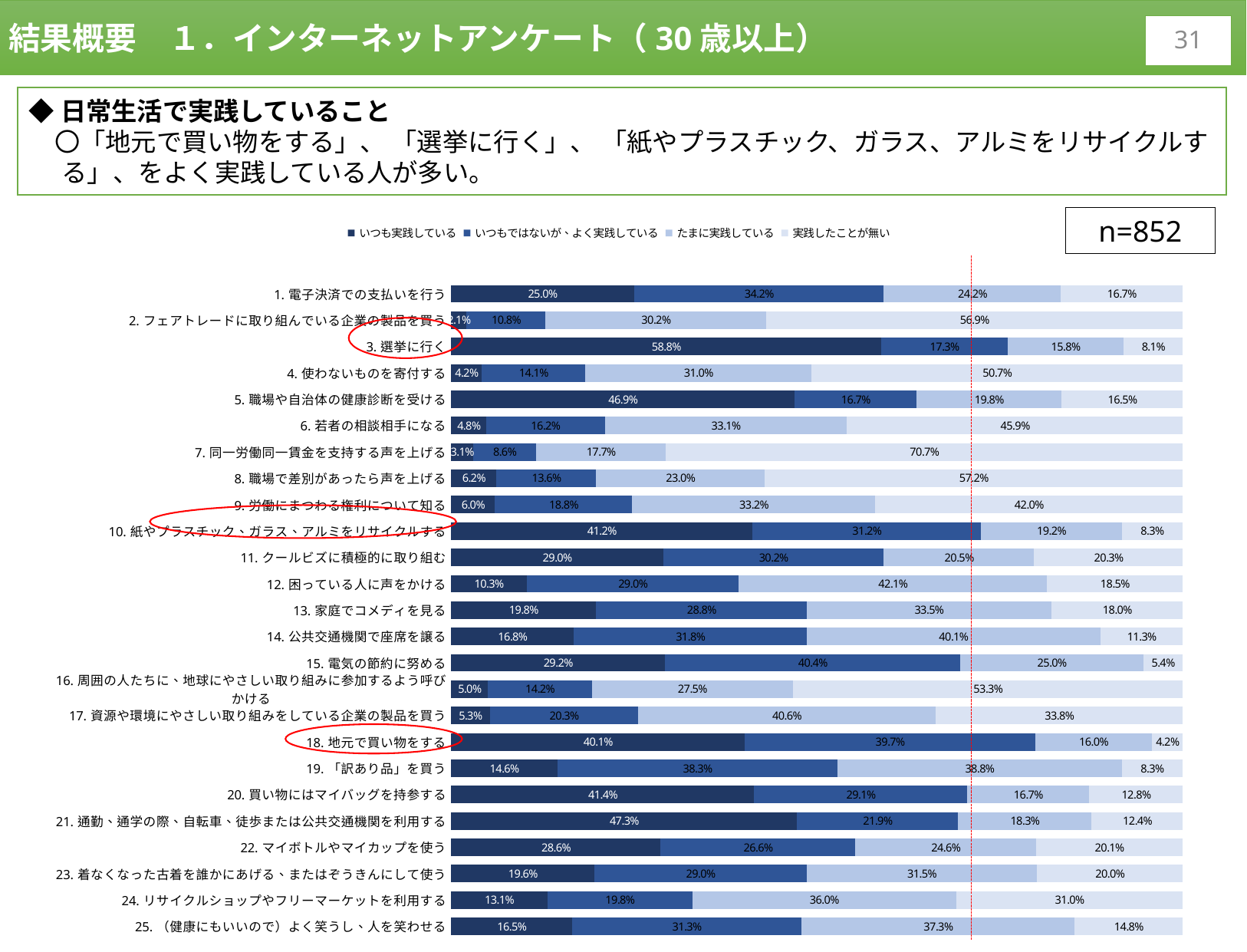
How many series does the legend list? 4 What is the value of 「いつもではないが、よく実践している」 for 「18. 地元で買い物をする」? 39.7% How many categories (items) are plotted in the chart? 25 What is the value of 「いつも実践している」 for 「3. 選挙に行く」? 58.8% Which item has the highest value for 「実践したことが無い」? 7. 同一労働同一賃金を支持する声を上げる What is the sample size (n) shown on the slide? n=852 Which has the larger 「いつも実践している」 value: 「1. 電子決済での支払いを行う」 or 「21. 通勤、通学の際、自転車、徒歩または公共交通機関を利用する」? 21. 通勤、通学の際、自転車、徒歩または公共交通機関を利用する Which item has the highest value for 「いつも実践している」? 3. 選挙に行く Which item has the lowest value for 「いつも実践している」? 2. フェアトレードに取り組んでいる企業の製品を買う What is the value of 「実践したことが無い」 for 「7. 同一労働同一賃金を支持する声を上げる」? 70.7% What kind of chart is shown on the slide? Stacked bar chart What is the difference between the 「いつも実践している」 values for 「3. 選挙に行く」 and 「18. 地元で買い物をする」? 18.7 percentage points